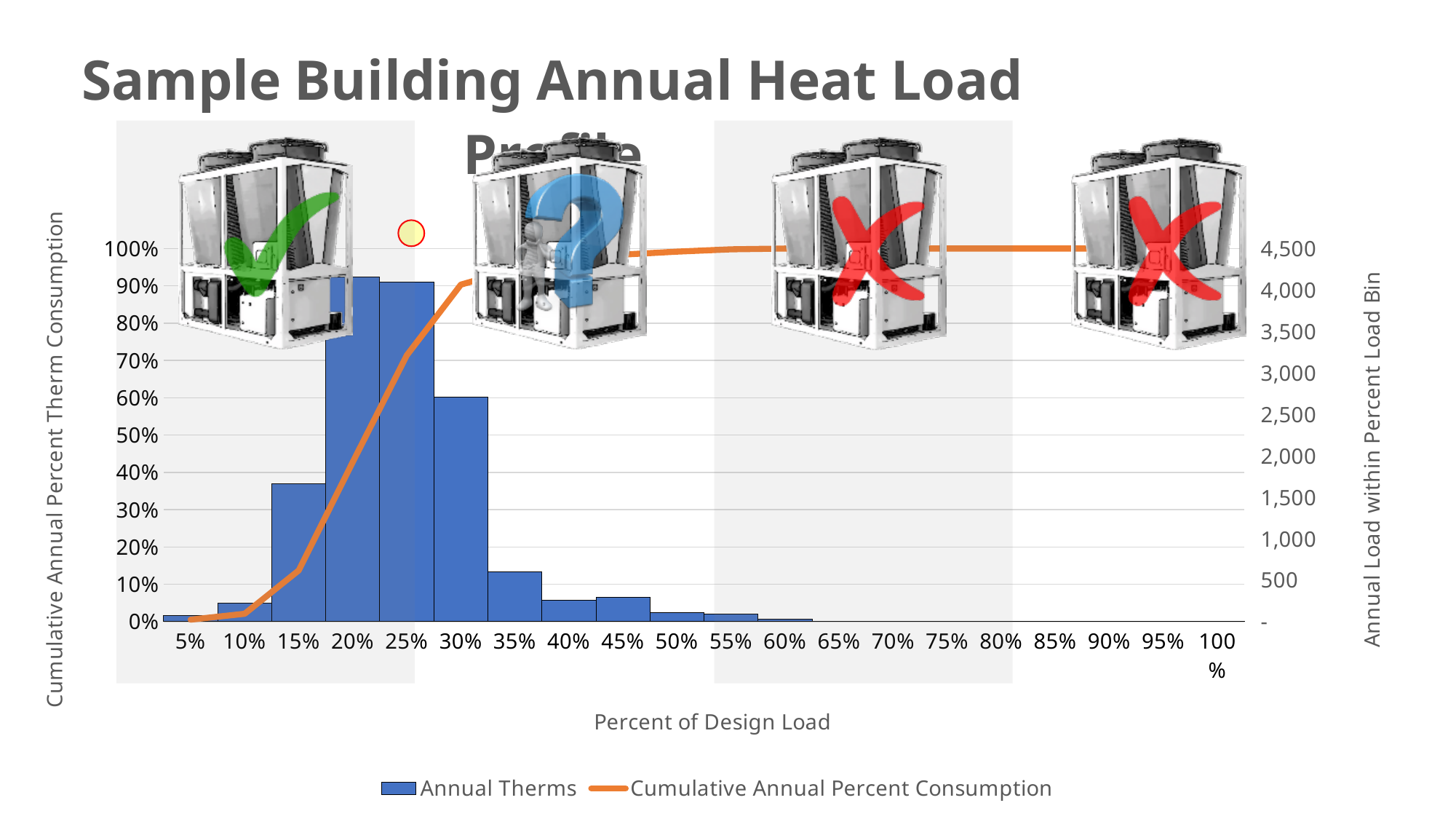
Which bin has the larger Annual Therms value, 15% or 35%? 15% How many percent-of-design-load bins are shown on the x axis? 20 Is the Cumulative Annual Percent Consumption at the 20% bin greater or less than 50%? less Is the Annual Therms value for the 40% bin greater or less than 500? less Is the Annual Therms value for the 30% bin greater or less than 2,500? greater Which series is drawn as a line? Cumulative Annual Percent Consumption Which bin has the larger Annual Therms value, 20% or 30%? 20% What is the title of the x axis? Percent of Design Load Does the Cumulative Annual Percent Consumption line rise or fall as the percent of design load increases? Rise How many series does the legend list? 2 What kind of chart is shown on the slide? Combination bar and line chart